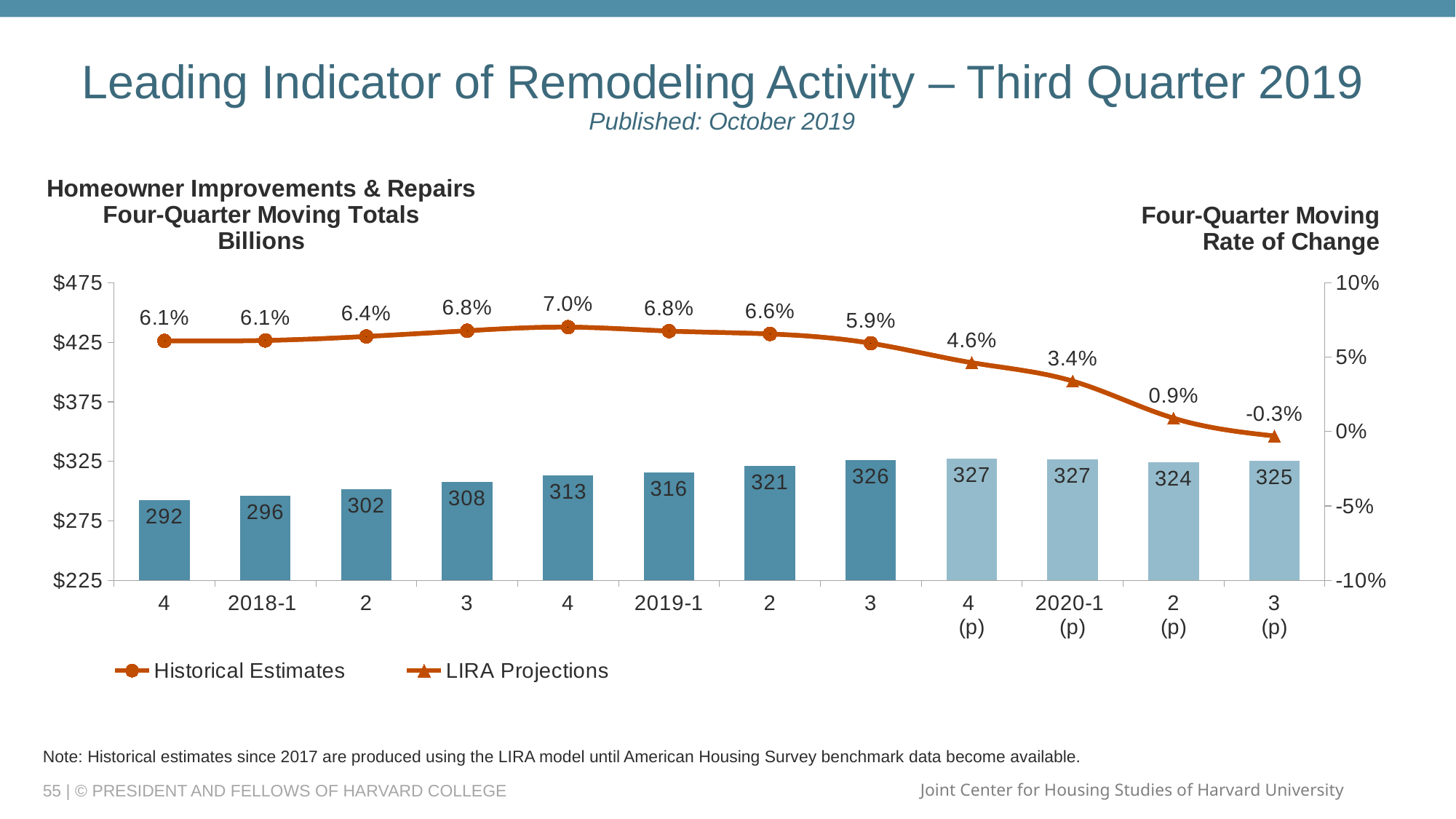
What is the four-quarter moving rate of change projected for 2020-1 (p)? 3.4% Does the four-quarter moving rate of change rise or fall from 2019-3 through 2020-3 (p)? fall What is the four-quarter moving total (in billions) for 2019-1? 316 Which quarter has the highest four-quarter moving rate of change? 2018-4 (7.0%) How many series does the chart legend list? 2 What are the two entries in the chart legend? Historical Estimates and LIRA Projections Which quarter has the lowest four-quarter moving rate of change? 2020-3 (p) (-0.3%) Which has the larger four-quarter moving total, 2020-2 (p) or 2020-3 (p)? 2020-3 (p) What is the difference between the four-quarter moving total for 2019-3 (326) and for 2017-4 (292)? 34 What kind of chart is shown on the slide? Combination bar and line chart How many quarters are shown on the x axis of the chart? 12 Is the four-quarter moving total bar for 2018-1 greater or less than $325 billion? less